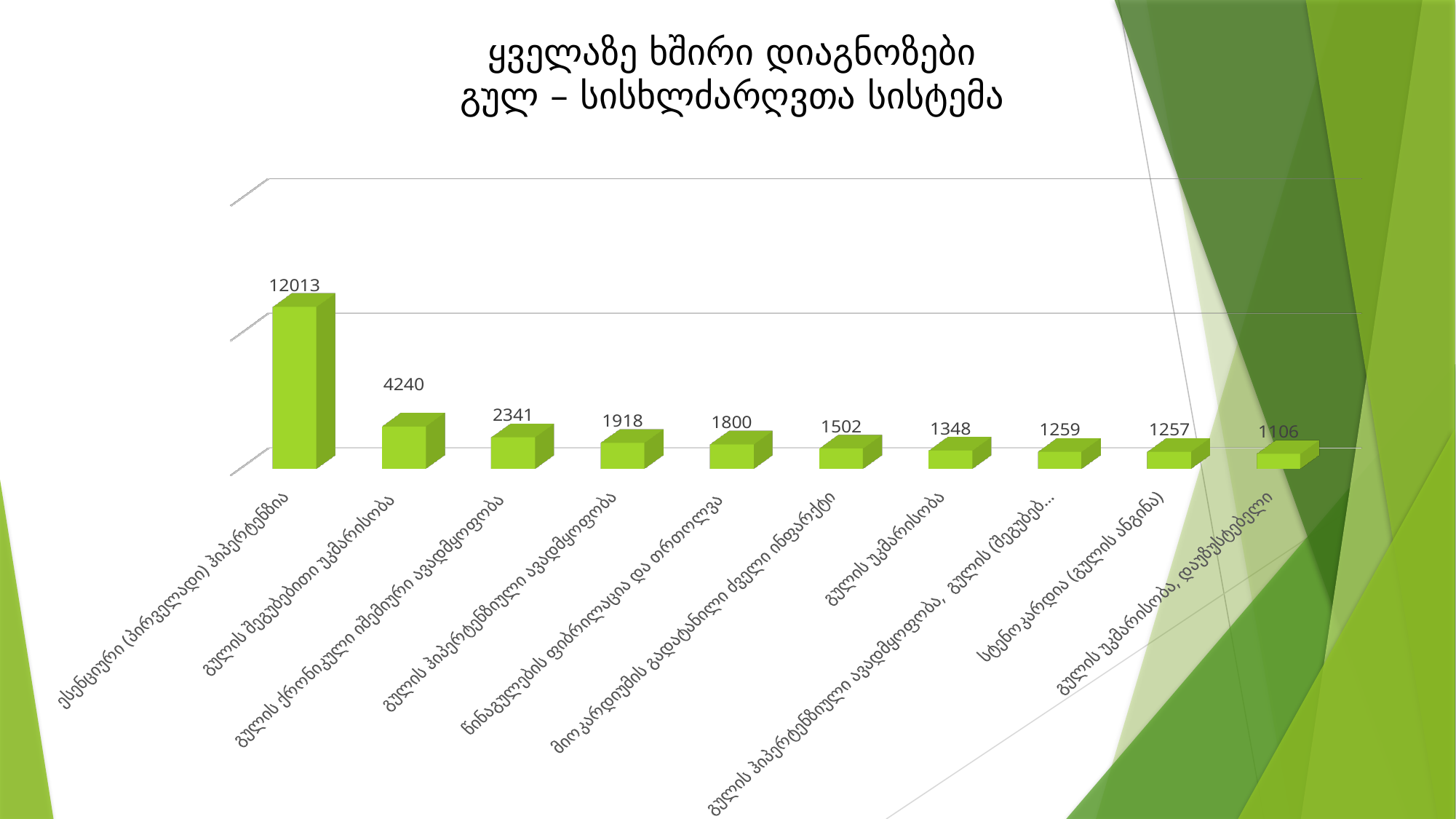
Which category has the lowest value? გულის უკმარისობა, დაუზუსტებელი Do the values rise or fall from left to right along the x axis? fall What is the difference between the values for ესენციური (პირველადი) ჰიპერტენზია and გულის შეგუბებითი უკმარისობა? 7773 What is the difference between the values for მიოკარდიუმის გადატანილი ძველი ინფარქტი and გულის უკმარისობა? 154 What is the value for გულის შეგუბებითი უკმარისობა? 4240 What type of chart is shown on the slide? bar chart How many categories (bars) does the chart show? 10 What is the value for ესენციური (პირველადი) ჰიპერტენზია? 12013 Which category has the highest value? ესენციური (პირველადი) ჰიპერტენზია What is the value for სტენოკარდია (გულის ანგინა)? 1257 Which is larger: the value for გულის ქრონიკული იშემიური ავადმყოფობა or the value for გულის უკმარისობა? გულის ქრონიკული იშემიური ავადმყოფობა What is the value for წინაგულების ფიბრილაცია და თრთოლვა? 1800